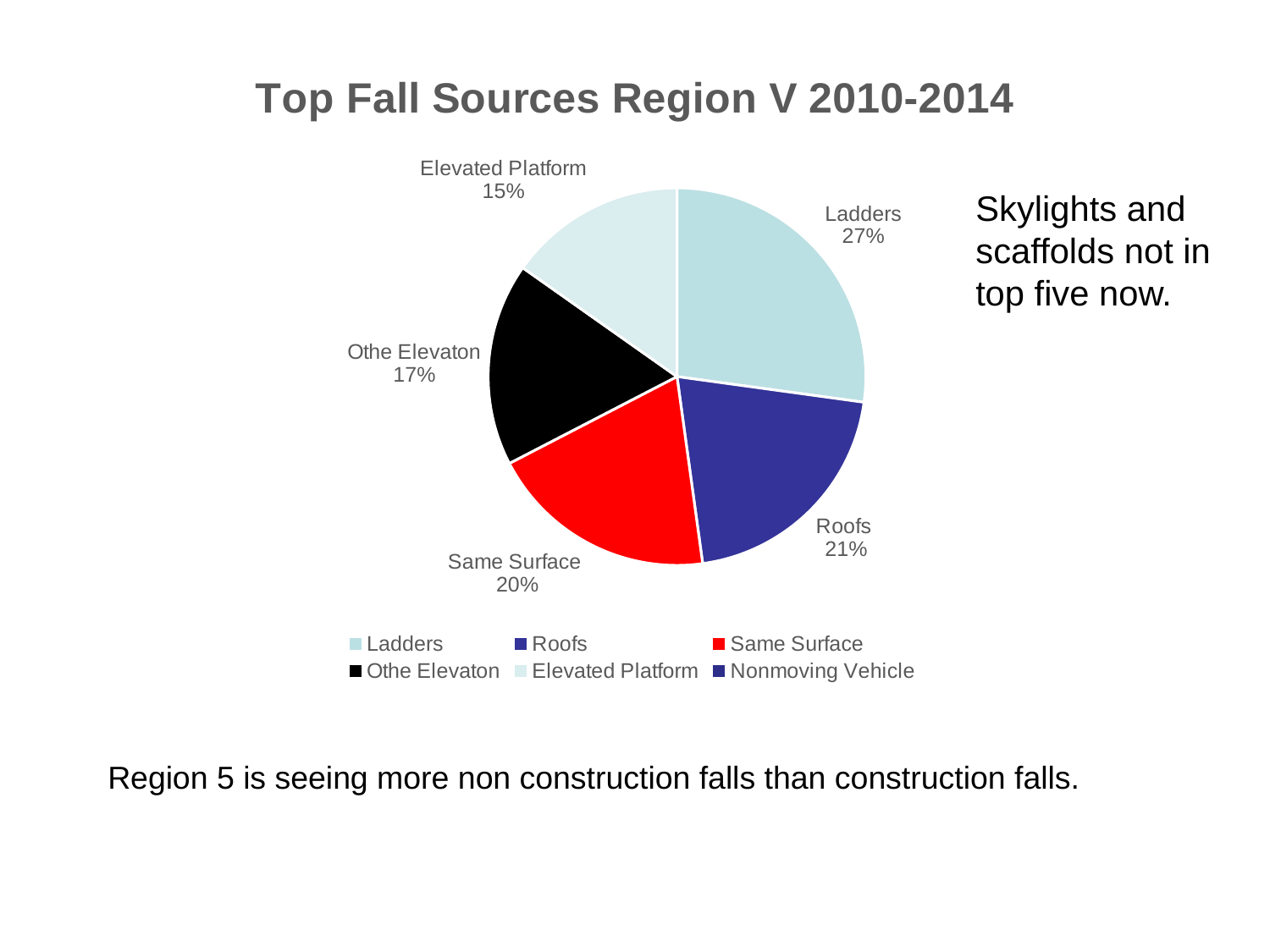
What percentage of falls is attributed to Same Surface? 20% Which has a larger share, Roofs or Same Surface? Roofs What is the title of the chart? Top Fall Sources Region V 2010-2014 What is the difference in percentage points between the Ladders share and the Elevated Platform share? 12 percentage points What percentage of falls is attributed to Ladders? 27% What percentage of falls is attributed to Elevated Platform? 15% Which labeled slice has the smallest share of the pie? Elevated Platform How many entries does the legend list? 6 What percentage of falls is attributed to Roofs? 21% What percentage of falls is attributed to Othe Elevaton? 17% Which fall source has the largest share of the pie? Ladders What kind of chart is shown on the slide? Pie chart